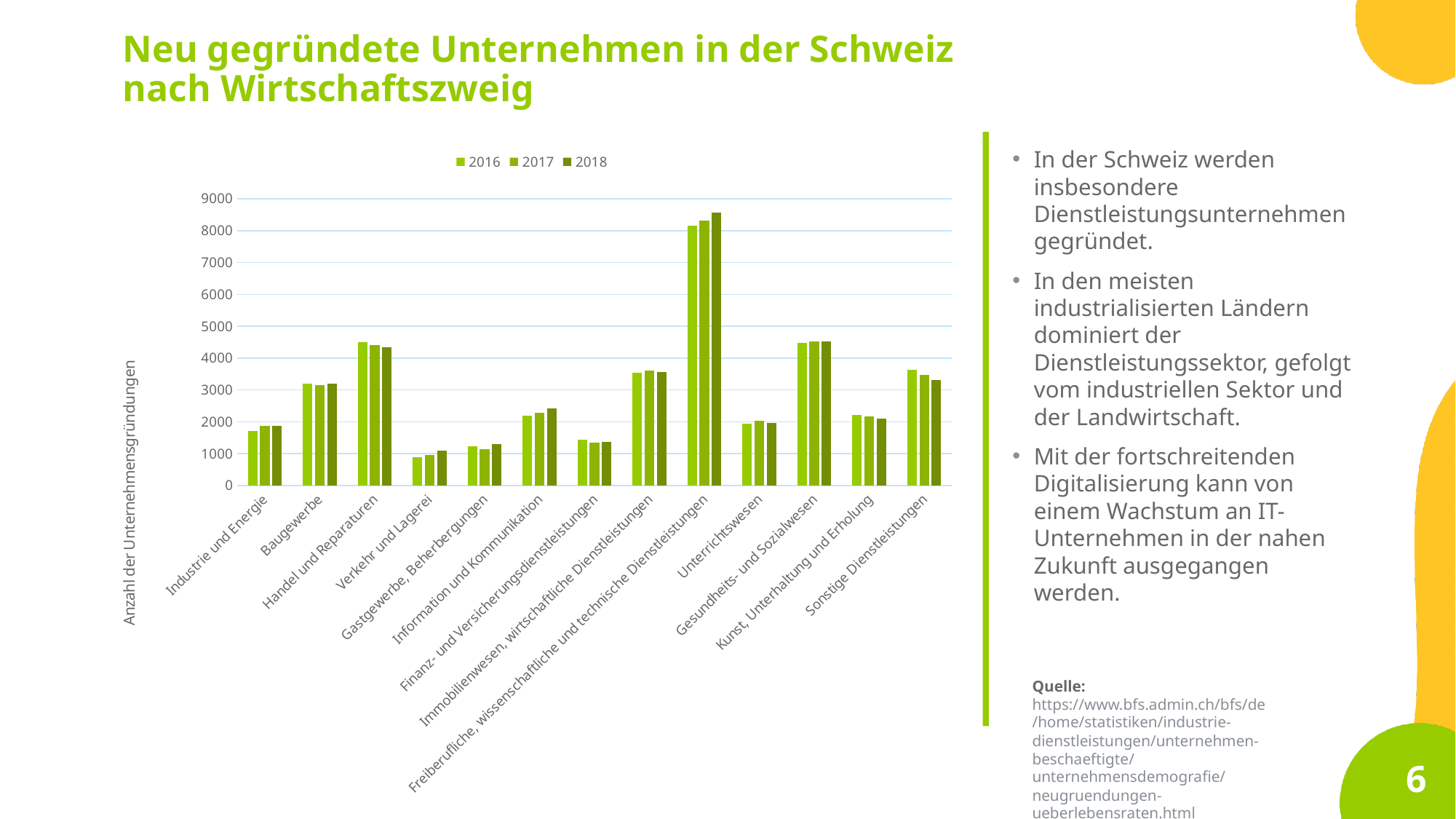
Which category has the highest number of Unternehmensgründungen? Freiberufliche, wissenschaftliche und technische Dienstleistungen Is the 2016 value for Baugewerbe greater or less than 3000? greater Is the 2016 value for Industrie und Energie greater or less than 2000? less How many categories (Wirtschaftszweige) are shown on the x axis? 13 Do the values for Freiberufliche, wissenschaftliche und technische Dienstleistungen rise or fall from 2016 to 2018? rise Which category has the lowest number of Unternehmensgründungen? Verkehr und Lagerei What kind of chart is shown on the slide? bar chart Which is larger in 2016: Handel und Reparaturen or Baugewerbe? Handel und Reparaturen Is the 2018 value for Freiberufliche, wissenschaftliche und technische Dienstleistungen greater or less than 8000? greater How many series does the legend list? 3 What is the label of the y axis? Anzahl der Unternehmensgründungen